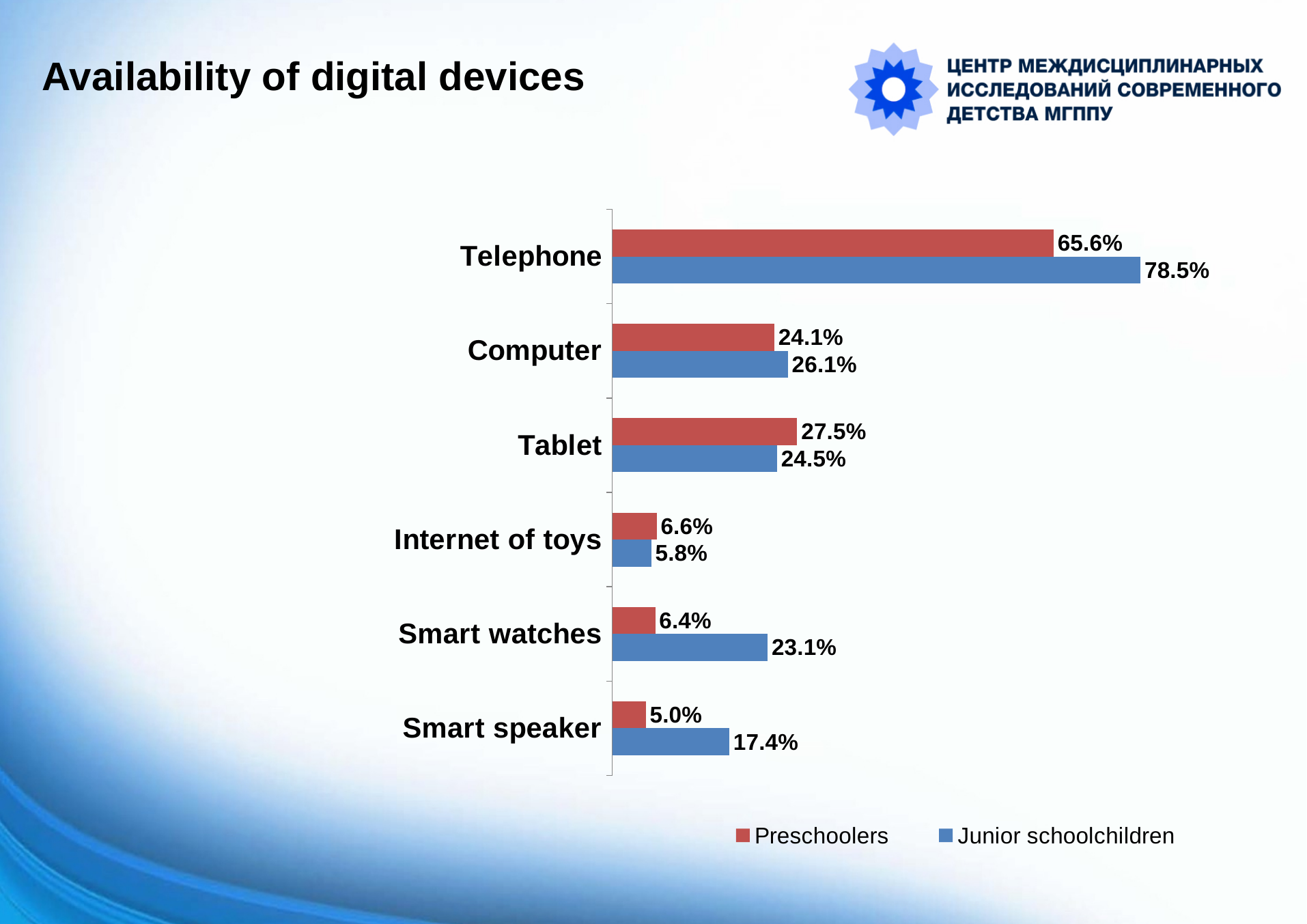
Which category has the lowest value in the Junior schoolchildren series? Internet of toys How many categories are shown on the chart? 6 What kind of chart is shown on the slide? Bar chart For Tablet, which series has the larger value, Preschoolers or Junior schoolchildren? Preschoolers Which category has the highest value in the Preschoolers series? Telephone How many series does the legend list? 2 What is the value for Smart watches in the Preschoolers series? 6.4% What is the value for Smart speaker in the Junior schoolchildren series? 17.4% What is the difference between the Junior schoolchildren and Preschoolers values for Smart watches? 16.7% Which colour represents the Preschoolers series? Red What is the difference between the Junior schoolchildren and Preschoolers values for Telephone? 12.9% What is the value for Telephone in the Junior schoolchildren series? 78.5%